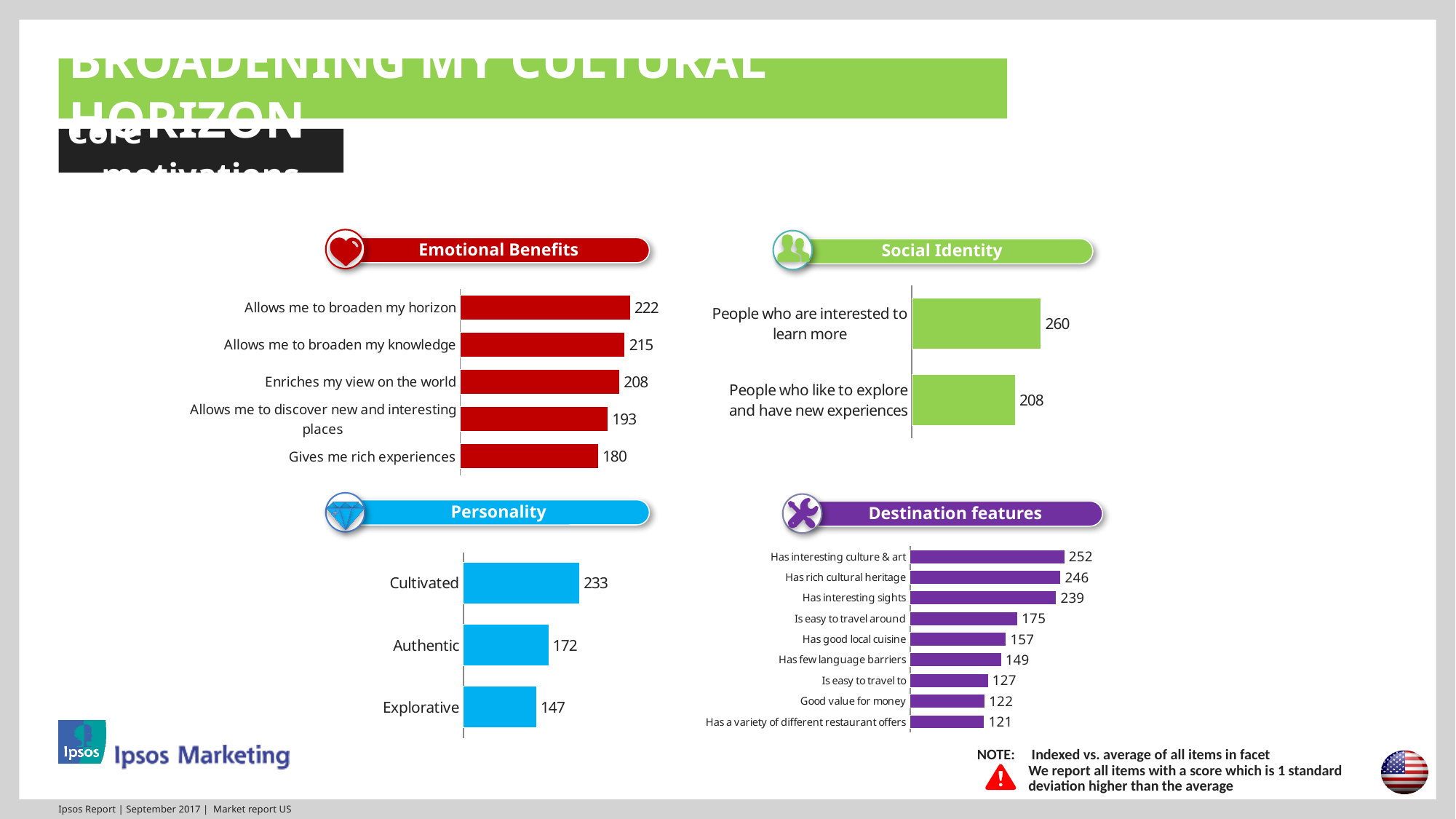
In the Personality chart, what is the difference between Cultivated and Explorative? 86 In the Social Identity chart, what is the value for "People who like to explore and have new experiences"? 208 What colour are the bars in the Personality chart? Blue In the Destination features chart, what is the value for "Has good local cuisine"? 157 In the Destination features chart, how many categories are shown? 9 In the Social Identity chart, how many categories are shown? 2 What kind of chart is the Destination features chart? Bar chart In the Emotional Benefits chart, which category has the lowest value? Gives me rich experiences In the Personality chart, which category has the highest value? Cultivated In the Emotional Benefits chart, what is the value for "Allows me to broaden my horizon"? 222 In the Emotional Benefits chart, what is the difference between "Allows me to broaden my knowledge" and "Enriches my view on the world"? 7 In the Destination features chart, which is larger: "Is easy to travel around" or "Has few language barriers"? Is easy to travel around